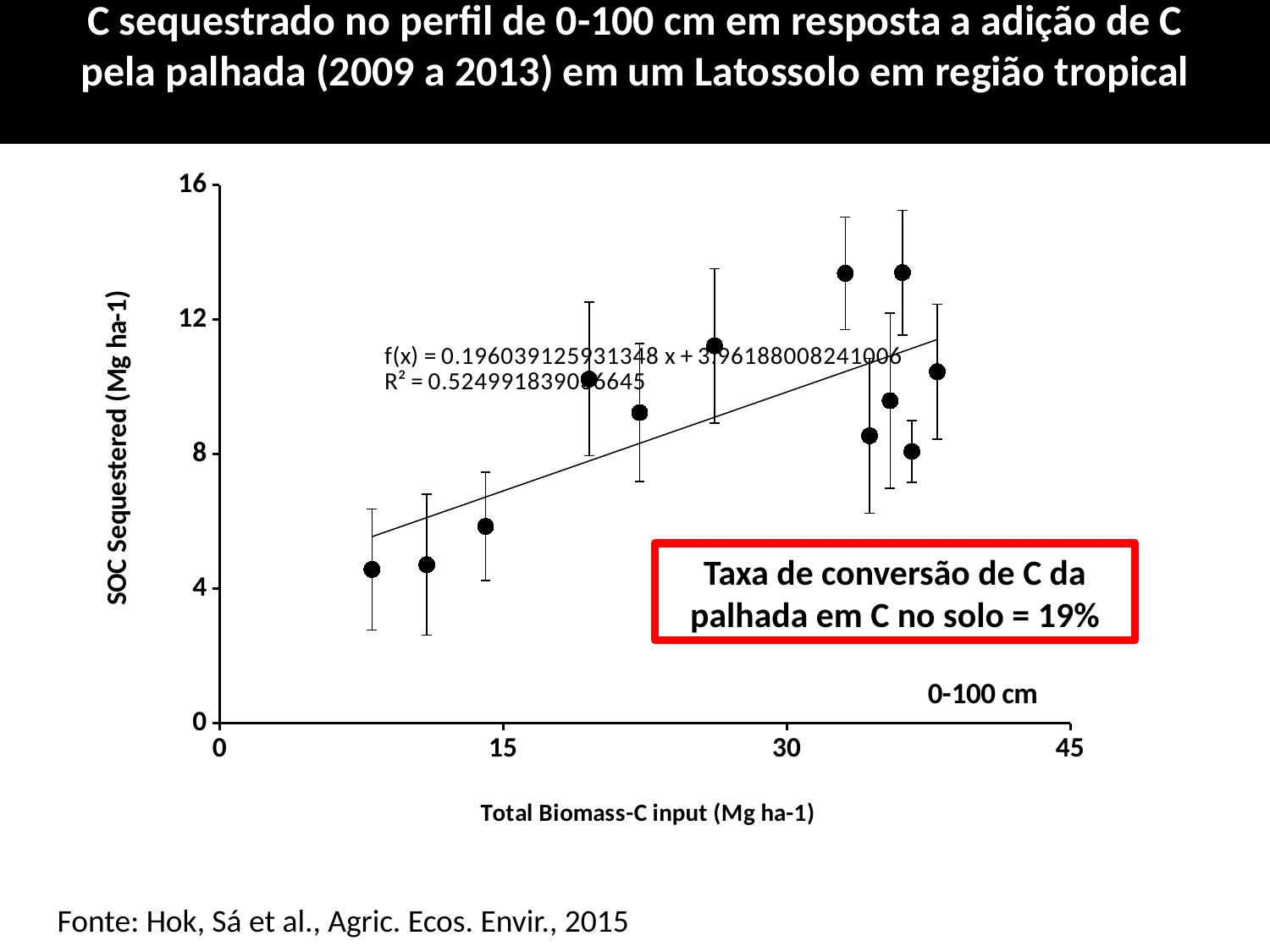
Is the SOC Sequestered value for the point at about 14 Mg ha-1 biomass-C input greater or less than 8? less What kind of chart is shown on the slide? Scatter plot Do the SOC Sequestered values generally rise or fall as Total Biomass-C input increases? Rise What is the slope of the fitted line shown in the trendline equation? 0.196039125931348 What is the maximum value shown on the y axis? 16 Is the SOC Sequestered value for the highest points (near 33 and 36 Mg ha-1 biomass-C input) greater or less than 12? greater What is the title of the x axis? Total Biomass-C input (Mg ha-1) How many data points are plotted on the chart? 12 What is the maximum value shown on the x axis? 45 Is the SOC Sequestered value for the leftmost point (at about 8 Mg ha-1 biomass-C input) greater or less than 8? less According to the red box on the chart, what is the conversion rate of straw C into soil C? 19%